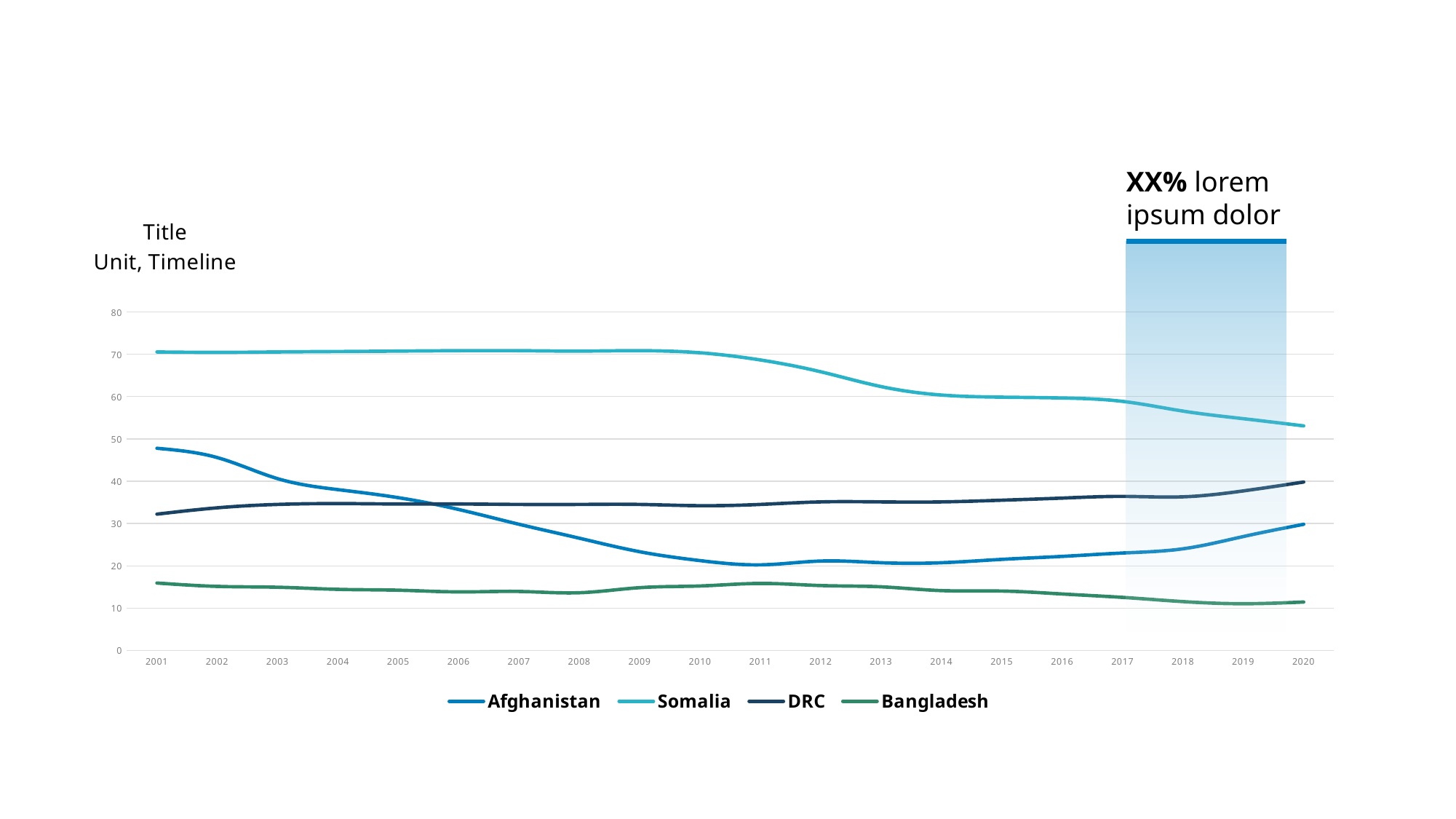
Which series has the lowest value in 2020? Bangladesh Is the value for Afghanistan in 2011 greater or less than 30? less Does the Afghanistan line rise or fall from 2001 to 2011? fall Is the value for Somalia in 2020 greater or less than 60? less Which is larger in 2020, the value for Afghanistan or the value for DRC? DRC Which is larger in 2001, the value for Afghanistan or the value for DRC? Afghanistan How many series does the legend list? 4 Which years does the shaded highlight region on the chart cover? 2017 to 2020 Is the value for DRC in 2020 greater or less than 30? greater How many years are shown along the x axis? 20 What kind of chart is shown on the slide? line chart Which series has the highest value in 2020? Somalia